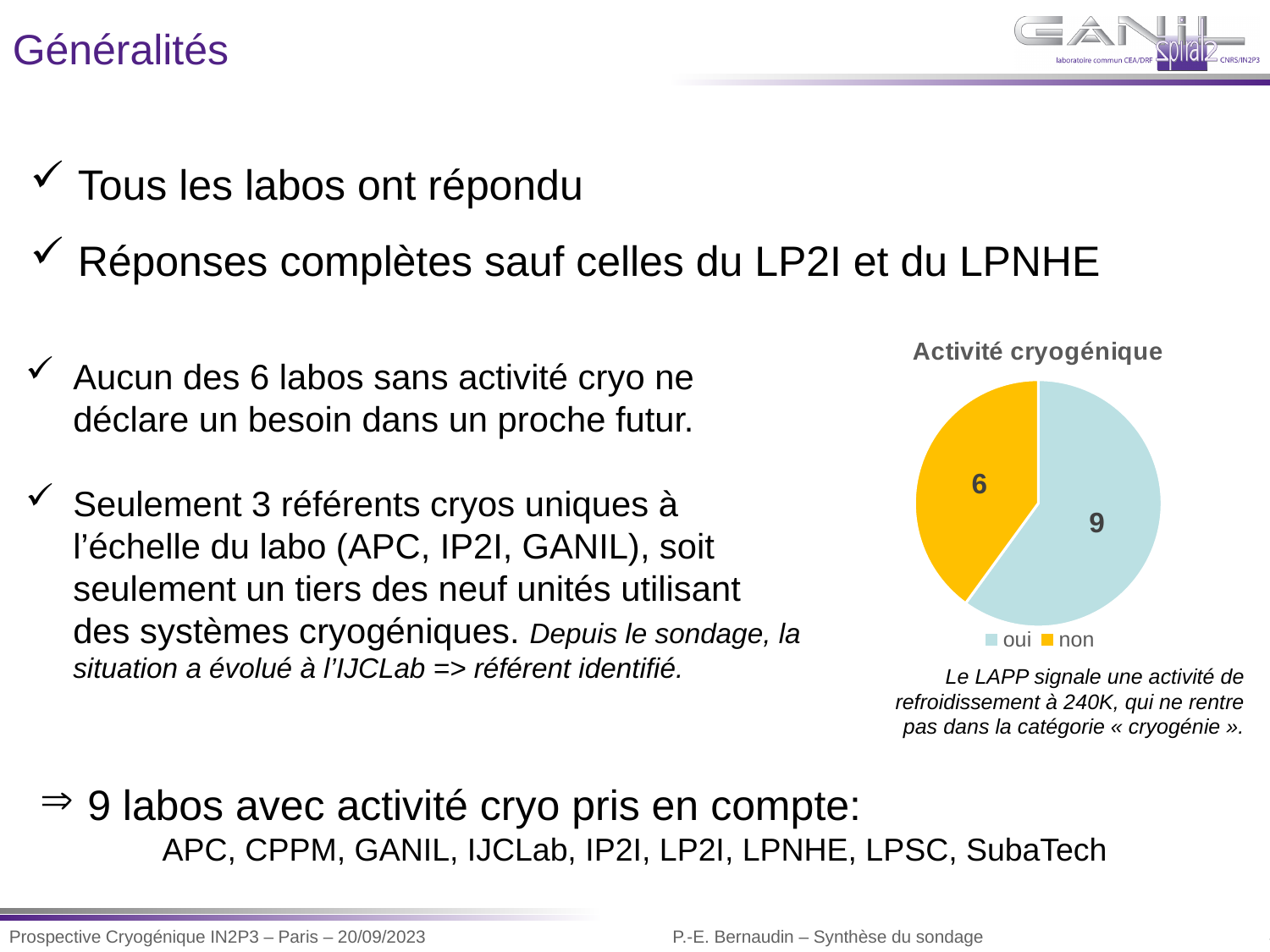
How many entries does the legend list? 2 Which category has the smallest slice in the pie chart? non Which is larger, the value for "oui" or the value for "non"? oui What share of the pie does the "oui" slice represent? 60% What is the total of all slices in the pie chart? 15 What is the value for "oui" in the pie chart? 9 What is the difference between the "oui" and "non" values? 3 Which category has the largest slice in the pie chart? oui How many categories does the pie chart have? 2 What is the title of the chart? Activité cryogénique What type of chart is shown on the slide? pie chart What is the value for "non" in the pie chart? 6